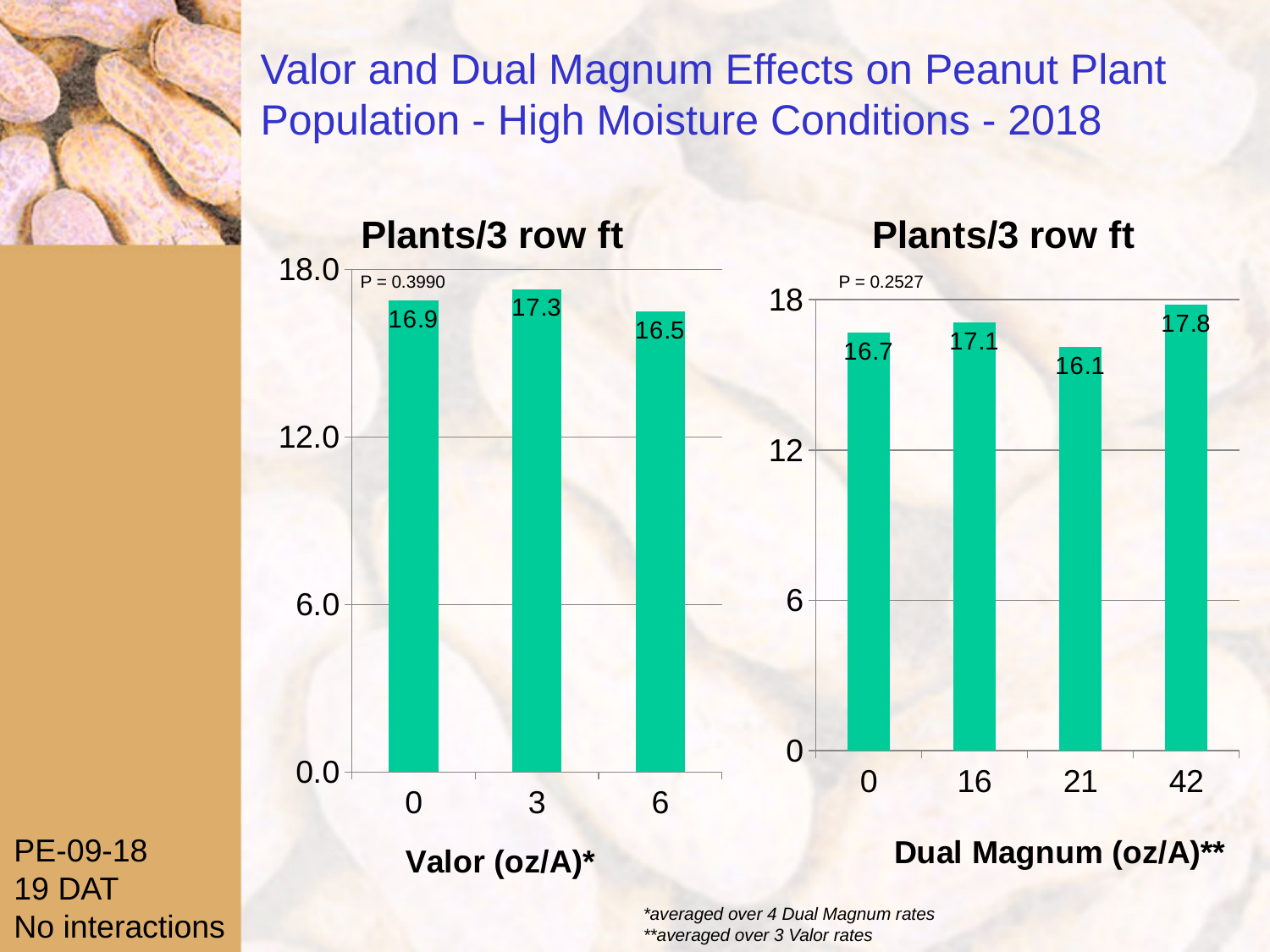
In the right chart (Dual Magnum oz/A), is the value for the 0 oz/A rate greater or less than 12? greater In the left chart (Valor oz/A), what is the value for the 3 oz/A rate? 17.3 In the right chart (Dual Magnum oz/A), which rate has the lowest plants/3 row ft? 21 In the right chart (Dual Magnum oz/A), which rate has the highest plants/3 row ft? 42 In the left chart (Valor oz/A), what is the difference between the values for the 3 and 6 oz/A rates? 0.8 What kind of chart is the left chart (Valor oz/A)? Bar chart In the right chart (Dual Magnum oz/A), what is the value for the 21 oz/A rate? 16.1 How many rates are shown in the right chart (Dual Magnum oz/A)? 4 What P value is shown on the right chart (Dual Magnum oz/A)? P = 0.2527 In the left chart (Valor oz/A), which rate has a larger value, 0 or 6? 0 In the right chart (Dual Magnum oz/A), what is the difference between the values for the 42 and 21 oz/A rates? 1.7 In the left chart (Valor oz/A), which rate has the lowest plants/3 row ft? 6